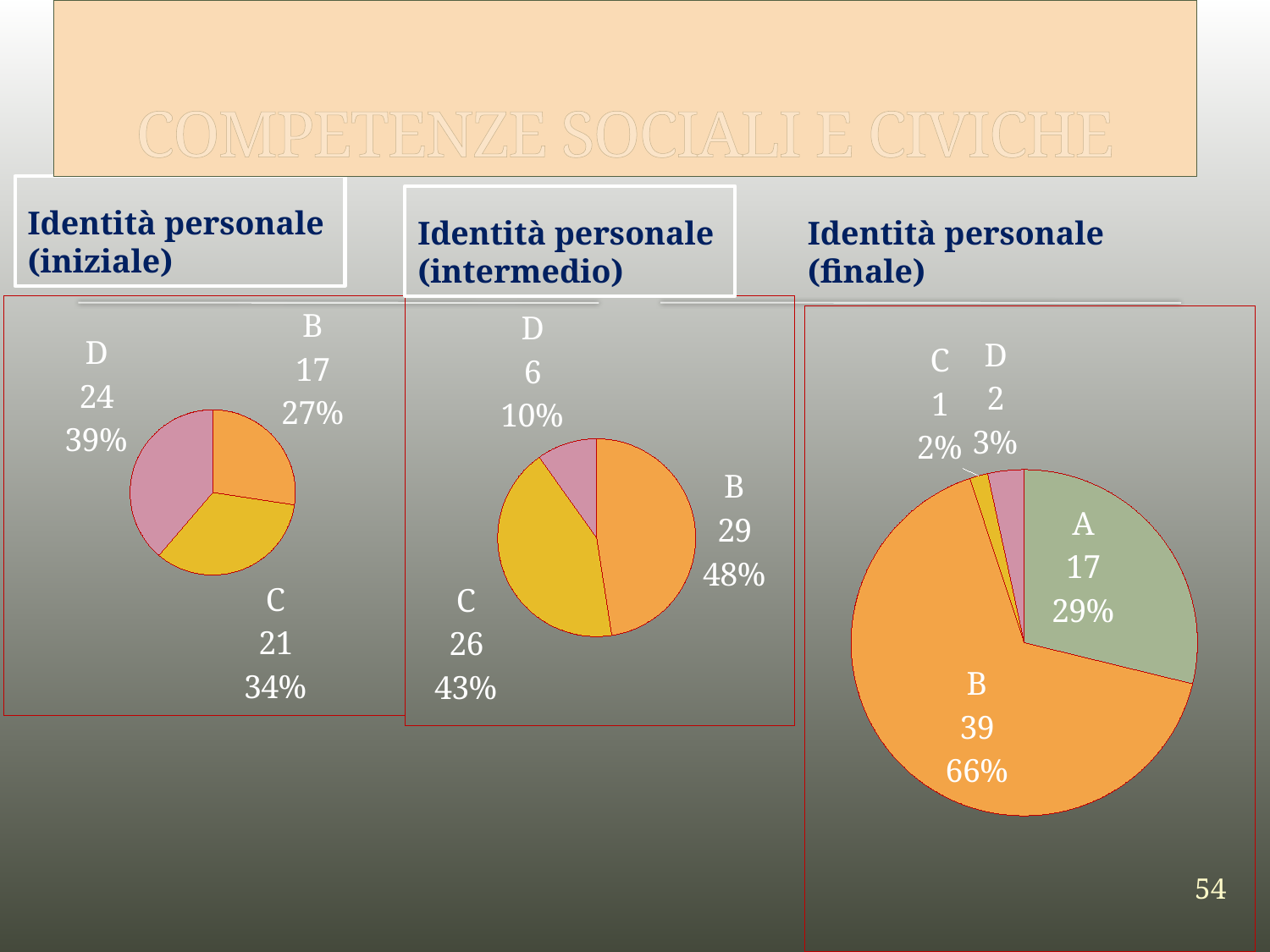
In the 'Identità personale (iniziale)' chart, which category has the largest slice? D In the 'Identità personale (finale)' chart, how many slices does the pie have? 4 In the 'Identità personale (finale)' chart, what is the value for category A? 17 What type of chart is used for 'Identità personale (finale)'? Pie chart In the 'Identità personale (intermedio)' chart, what is the difference between the values for B and C? 3 In the 'Identità personale (intermedio)' chart, which category has the smallest slice? D In the 'Identità personale (finale)' chart, which category has the largest slice? B In the 'Identità personale (iniziale)' chart, what is the value for category D? 24 In the 'Identità personale (intermedio)' chart, what share of the pie does category D have? 10% In the 'Identità personale (intermedio)' chart, what is the value for category B? 29 In the 'Identità personale (iniziale)' chart, how many slices does the pie have? 3 In the 'Identità personale (iniziale)' chart, what share of the pie does category C have? 34%